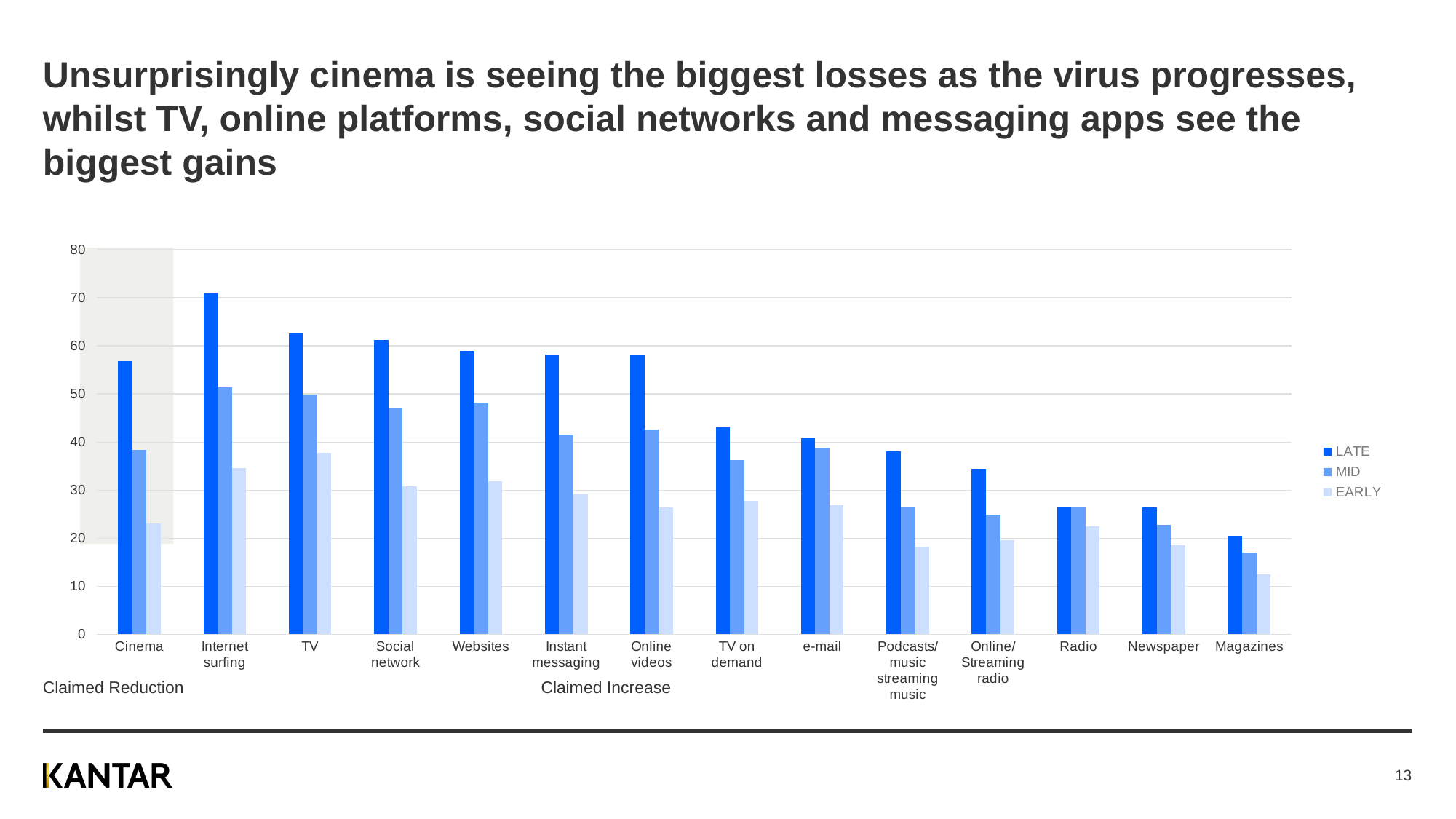
What kind of chart is shown on the slide? bar chart Which category has the lowest EARLY value? Magazines Is the LATE value for Cinema greater or less than 50? greater Which category has the lowest LATE value? Magazines Is the LATE value for Magazines greater or less than 30? less Which category is placed under the 'Claimed Reduction' label? Cinema How many categories are shown along the x axis? 14 Which is larger, the LATE value for Instant messaging or the LATE value for TV on demand? Instant messaging Is the LATE value for Internet surfing greater or less than 60? greater Which category has the highest LATE value? Internet surfing How many series does the legend list? 3